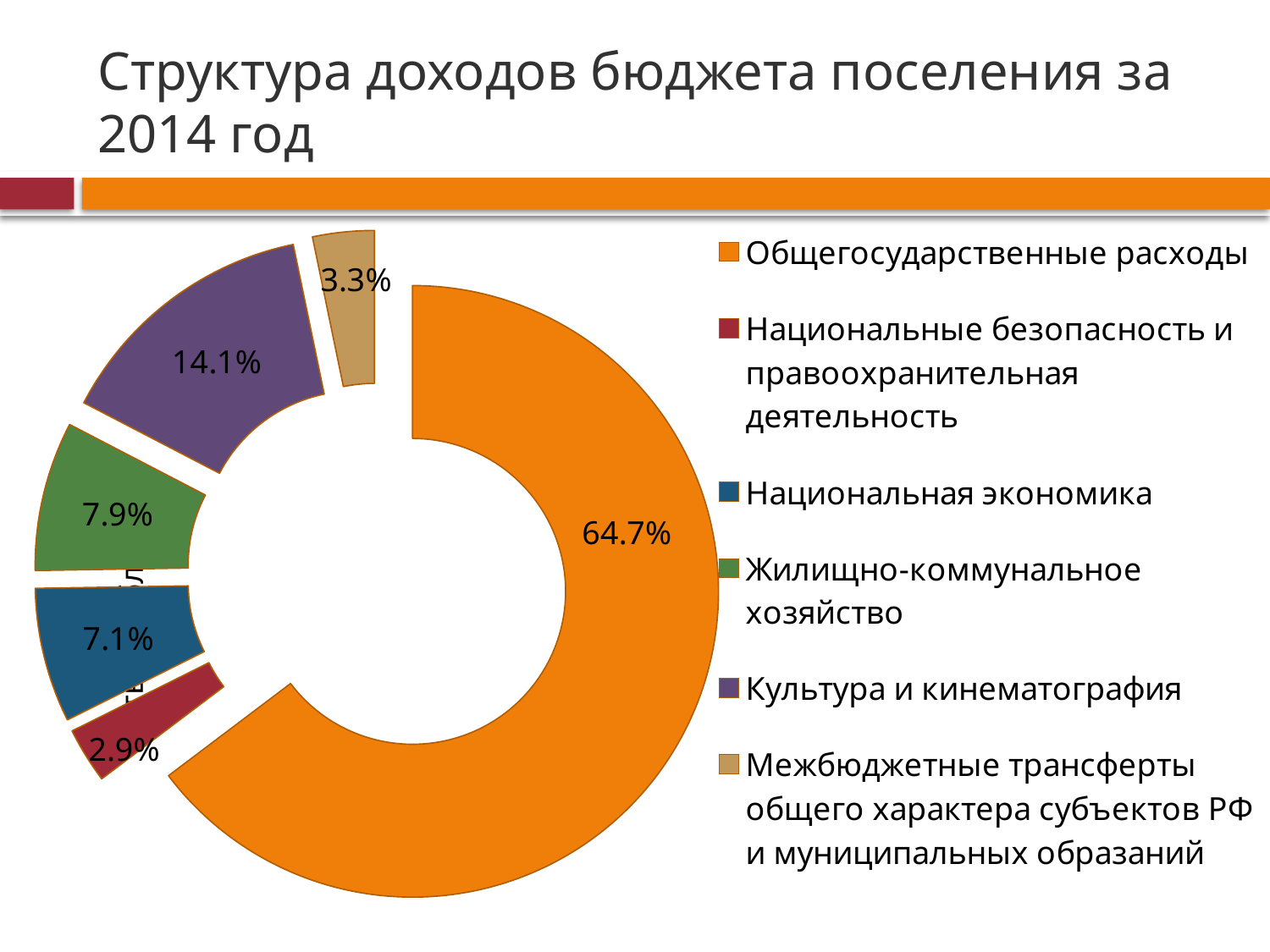
What is the value shown for Национальная экономика? 7.1% What colour is the slice for Культура и кинематография? Purple Which category has the smallest share of the chart? Национальные безопасность и правоохранительная деятельность How many categories does the legend list? 6 Which is larger: the share for Национальная экономика or the share for Межбюджетные трансферты общего характера субъектов РФ и муниципальных образований? Национальная экономика What is the value shown for Жилищно-коммунальное хозяйство? 7.9% Which category has the largest share of the chart? Общегосударственные расходы What kind of chart is shown on the slide? Doughnut (pie) chart What share of the chart does Общегосударственные расходы take? 64.7% What is the difference between the shares of Культура и кинематография and Жилищно-коммунальное хозяйство? 6.2% What is the value shown for Культура и кинематография? 14.1% What is the value shown for Межбюджетные трансферты общего характера субъектов РФ и муниципальных образований? 3.3%